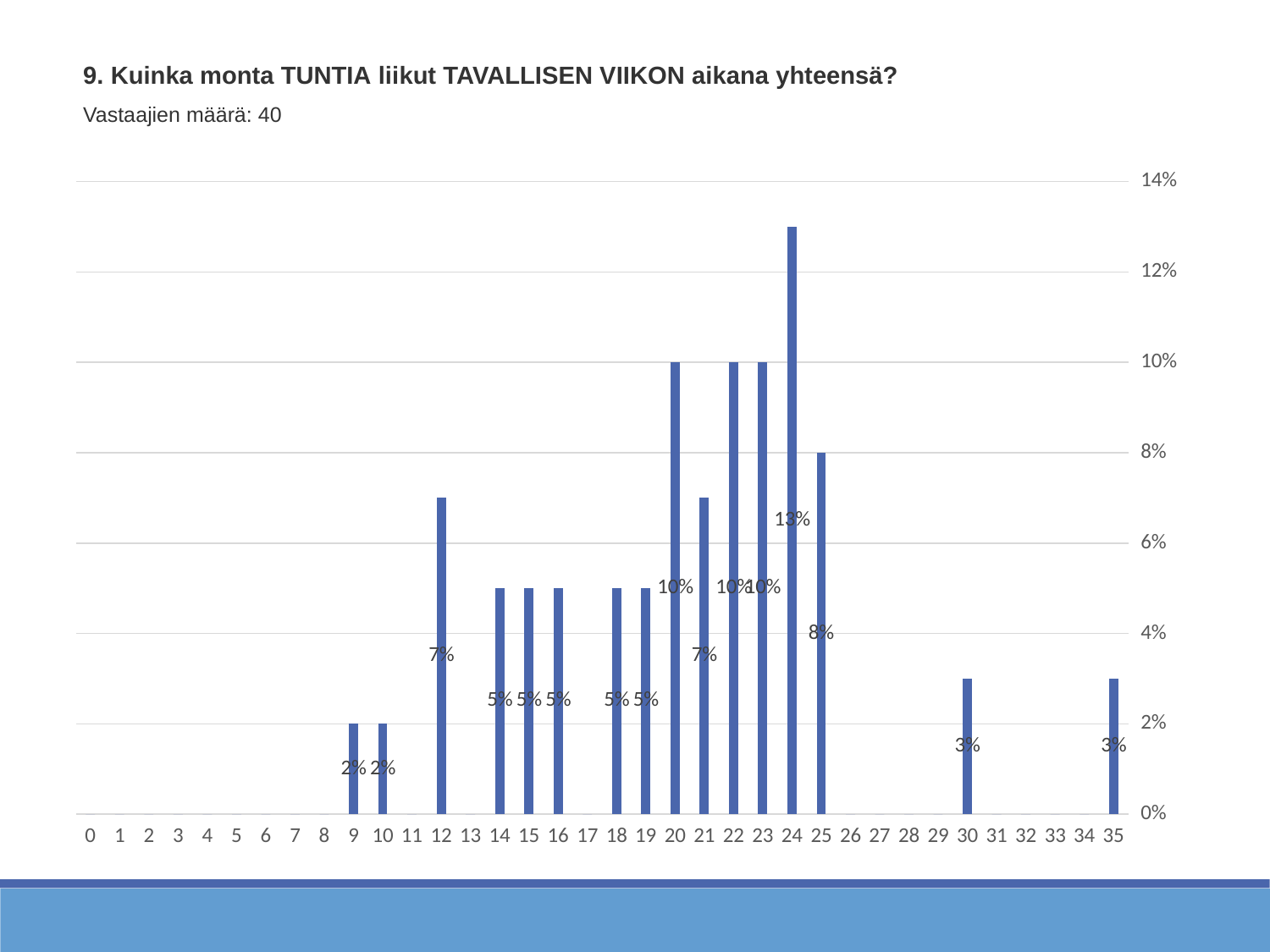
What is the value for category 30? 3% Which category has the highest value? 24 Which is larger, the value for category 22 or the value for category 25? 22 What is the difference between the values for category 24 and category 25? 5% What is the difference between the values for category 20 and category 21? 3% Is the value for category 24 greater or less than 12%? greater How many categories are labelled on the x axis? 36 What kind of chart is shown on the slide? bar chart What is the value for category 12? 7% What is the number of respondents stated on the slide? 40 What is the value for category 24? 13% What is the value for category 25? 8%